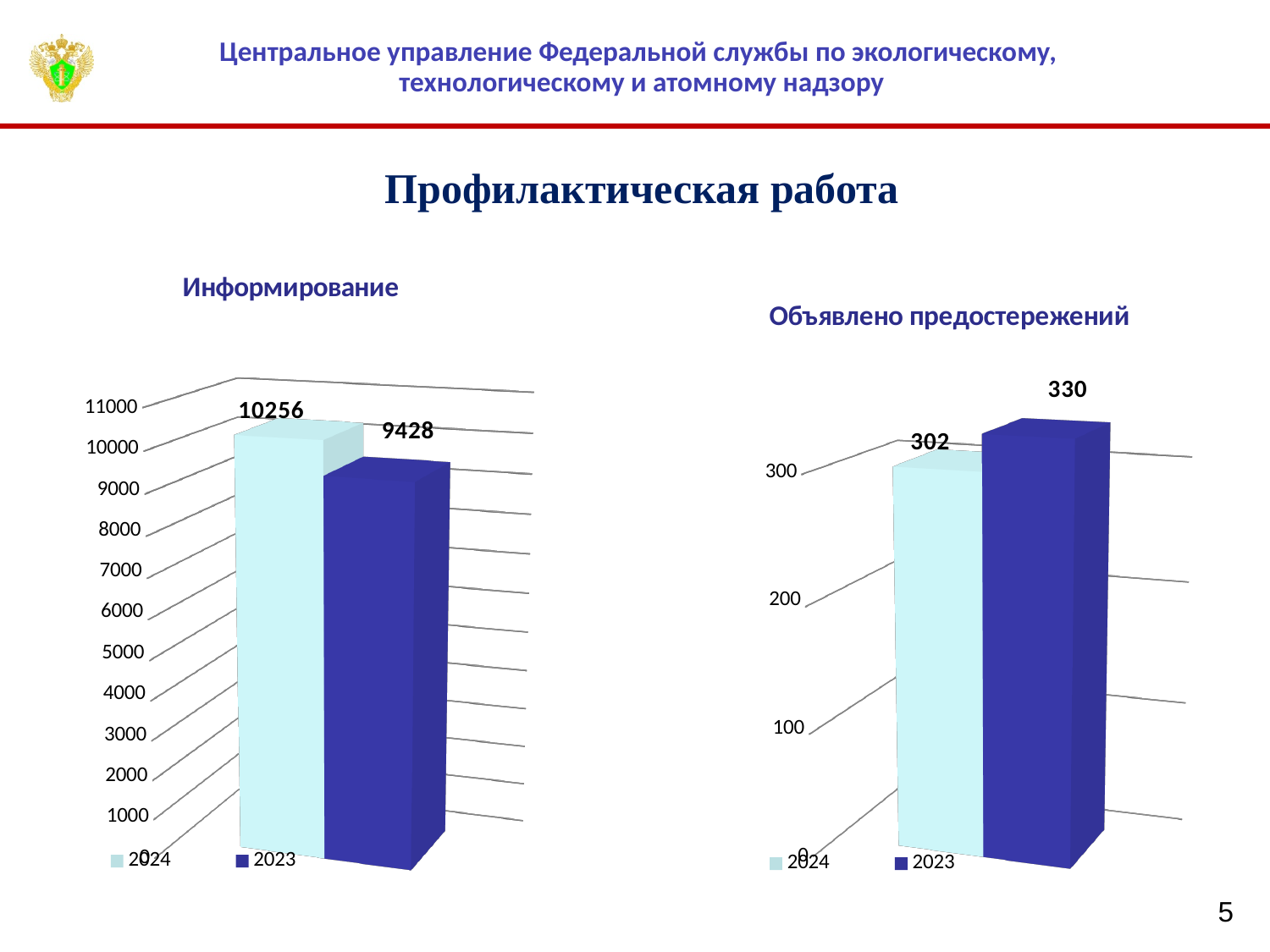
In the 'Информирование' chart, which year has the higher value? 2024 How many series does the legend of the 'Объявлено предостережений' chart list? 2 What type of chart is the 'Информирование' chart? bar chart In the 'Объявлено предостережений' chart, which year has the lower value? 2024 In the 'Объявлено предостережений' chart, what is the difference between the 2023 and 2024 values? 28 In the 'Информирование' chart, what is the value for 2023? 9428 In the 'Объявлено предостережений' chart, what is the value for 2024? 302 In the 'Объявлено предостережений' chart, what is the value for 2023? 330 In the 'Информирование' chart, what is the difference between the 2024 and 2023 values? 828 In the 'Информирование' chart, is the value for 2023 greater or less than 9000? greater In the 'Информирование' chart, what is the value for 2024? 10256 In the 'Объявлено предостережений' chart, is the value for 2023 larger or smaller than the value for 2024? larger